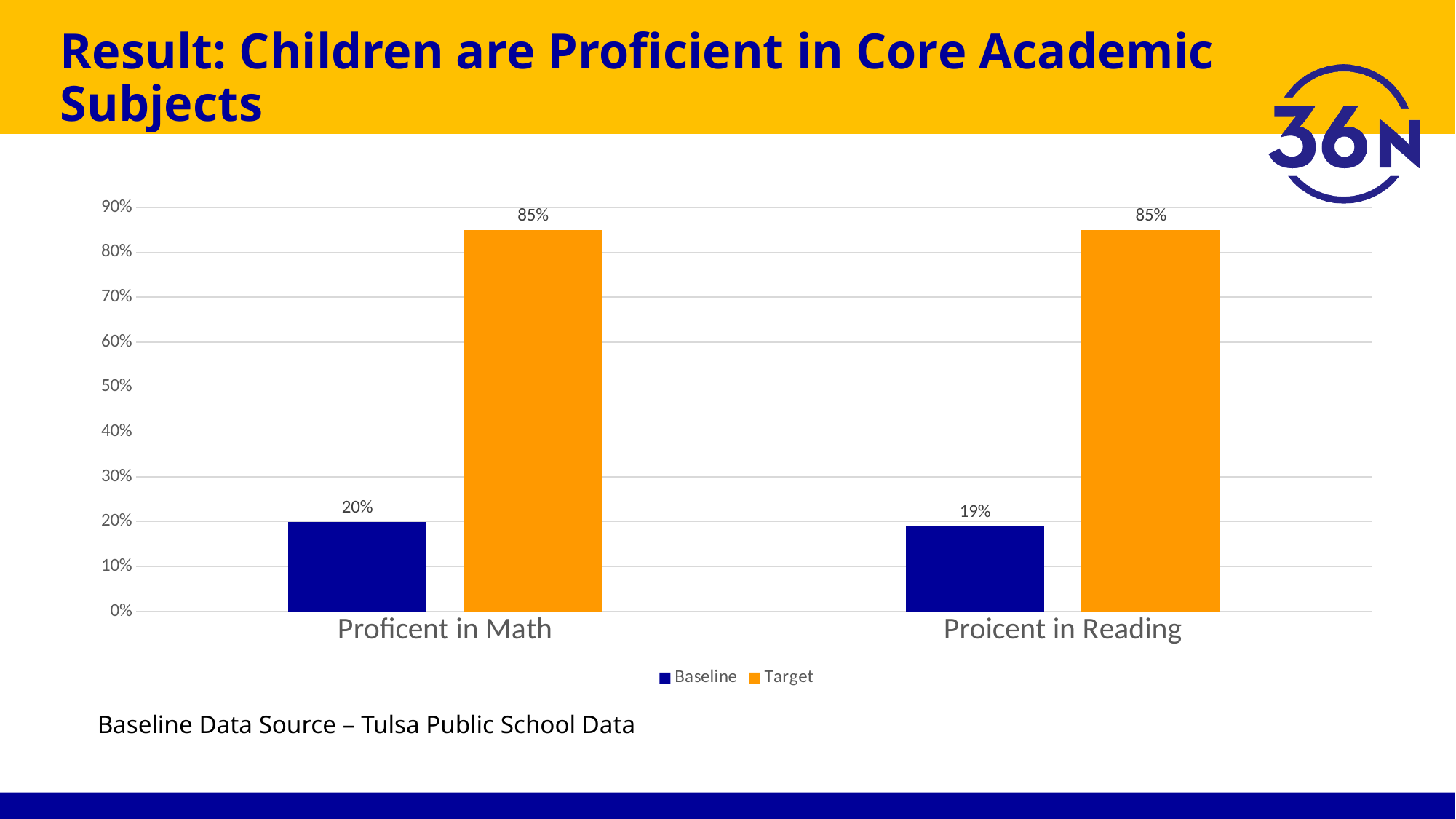
How many categories are shown on the x axis? 2 What is the Baseline value for Proicent in Reading? 19% What is the Target value for Proicent in Reading? 85% Which is larger for Proicent in Reading, the Baseline or the Target value? Target What is the difference between the Target and Baseline values for Proicent in Reading? 66% What is the data source given for the Baseline values? Tulsa Public School Data What kind of chart is shown on the slide? Bar chart What is the difference between the Target and Baseline values for Proficent in Math? 65% Which colour represents the Target series? Orange How many series does the legend list? 2 What is the Baseline value for Proficent in Math? 20% What is the Target value for Proficent in Math? 85%